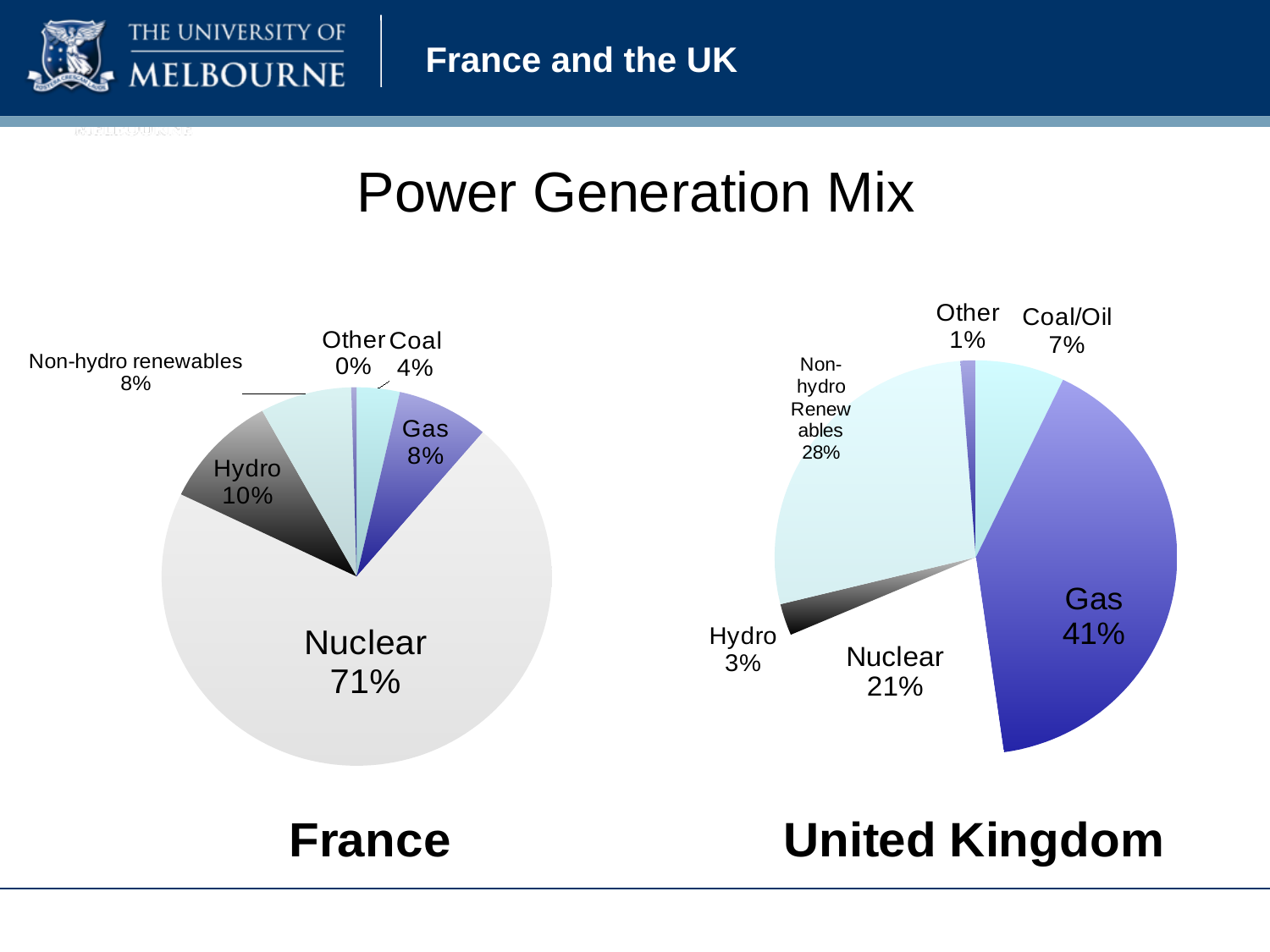
What type of chart is used for the United Kingdom power generation mix? Pie chart How many slices does the France pie chart have? 6 In the United Kingdom pie chart, which is larger: Coal/Oil or Hydro? Coal/Oil In the United Kingdom pie chart, what share of power generation is Gas? 41% In the United Kingdom pie chart, which category has the smallest share? Other In the United Kingdom pie chart, what is the value for Non-hydro Renewables? 28% What is the title shown above the two charts? Power Generation Mix In the United Kingdom pie chart, which category has the largest share? Gas In the France pie chart, what share of power generation is Nuclear? 71% What is the difference between the Nuclear share in the France chart and the Nuclear share in the United Kingdom chart? 50% In the France pie chart, what is the value for Hydro? 10% In the France pie chart, which category has the smallest share? Other